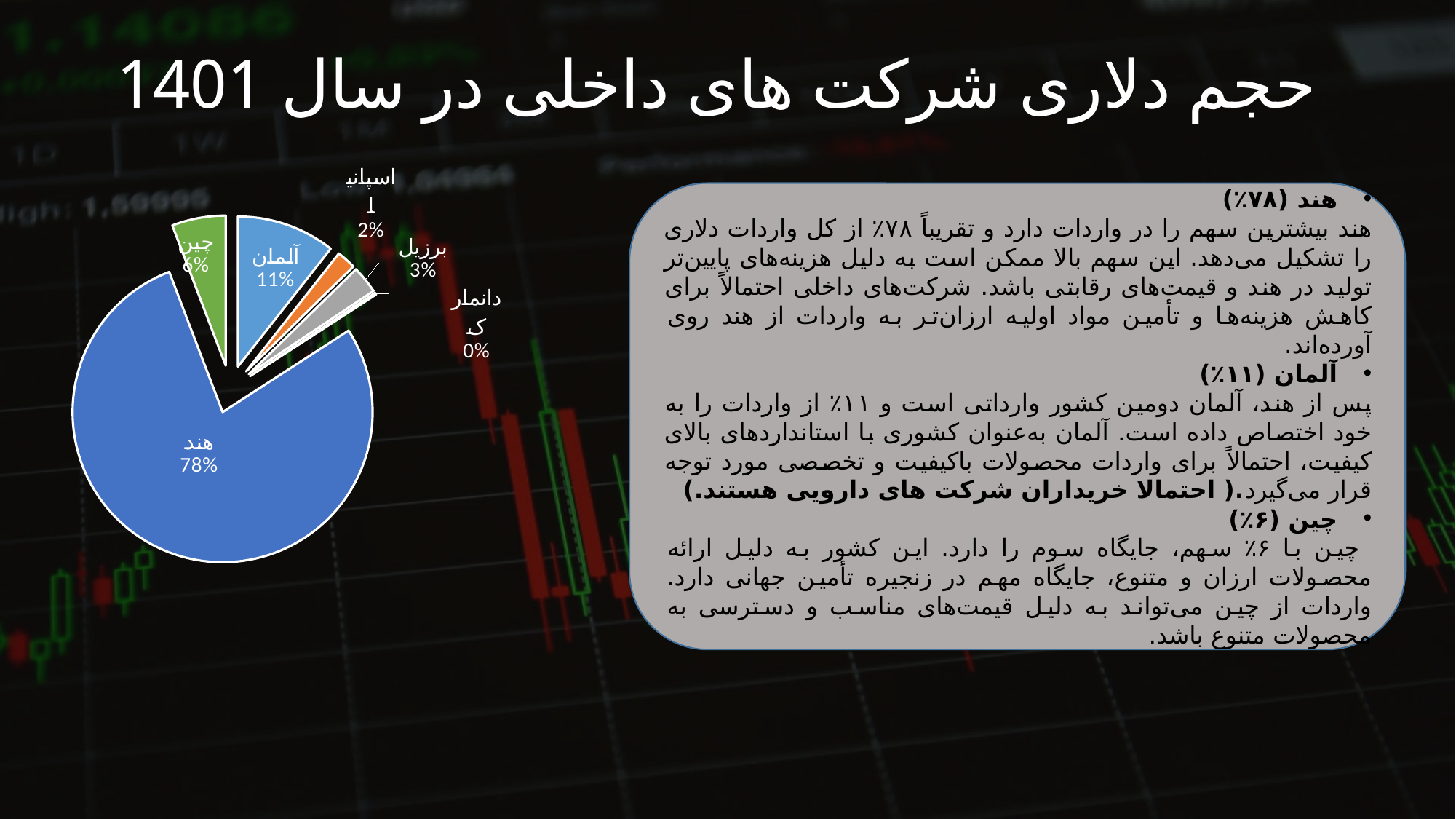
What is the difference between the shares of هند and آلمان? 67 percentage points Which country has the largest slice of the pie chart? هند How many countries are labelled in the pie chart? 6 What is the value shown for اسپانیا (Spain) in the pie chart? 2% Which country has the smallest slice of the pie chart? دانمارک What is the value shown for آلمان (Germany) in the pie chart? 11% What is the value shown for دانمارک (Denmark) in the pie chart? 0% Which has the larger share, چین or برزیل? چین What is the value shown for چین (China) in the pie chart? 6% What share of the pie does هند (India) hold? 78% What kind of chart is shown on the slide? pie chart What is the value shown for برزیل (Brazil) in the pie chart? 3%